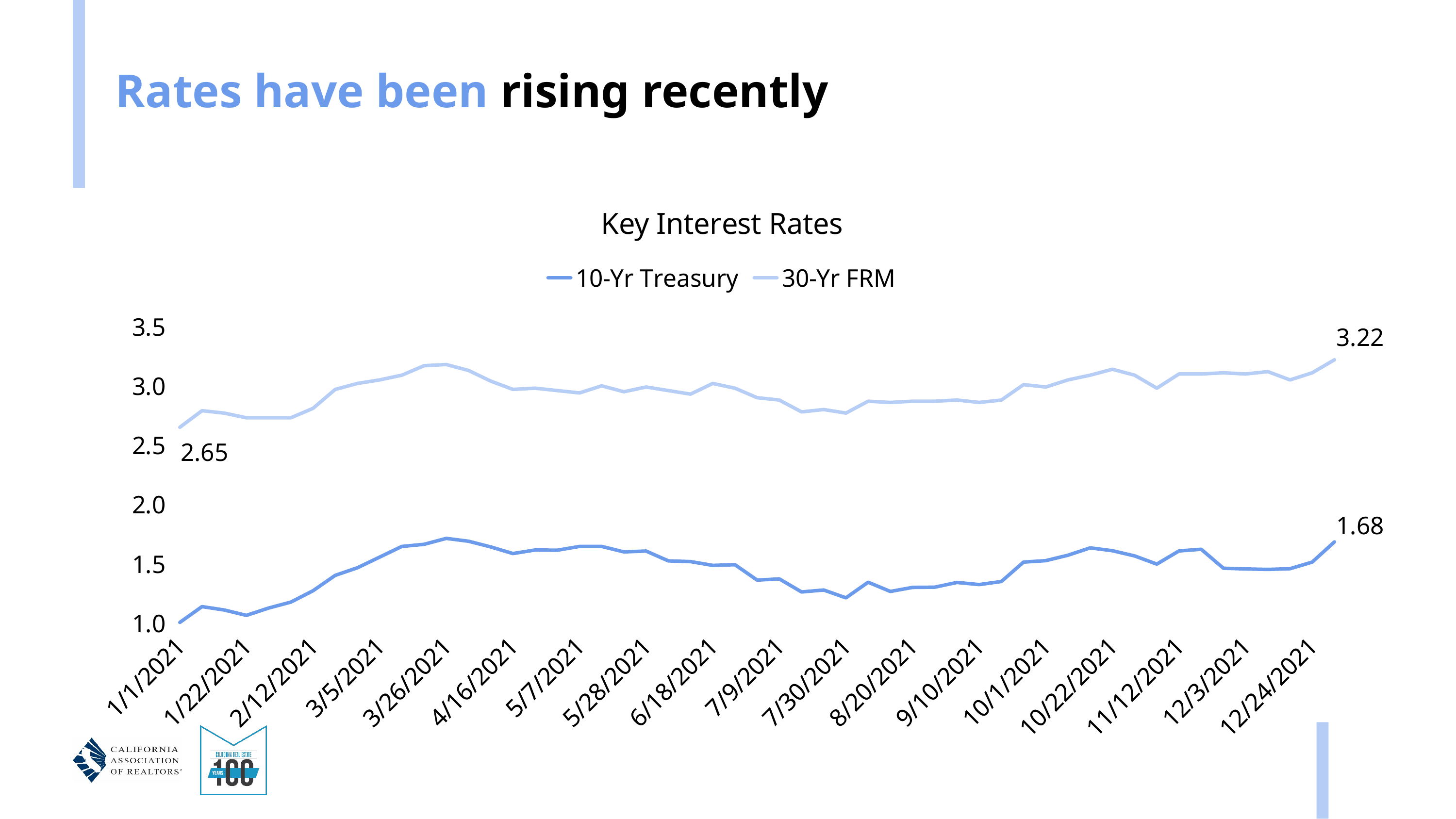
By how much did the 30-Yr FRM rise from its labeled starting value to its labeled ending value? 0.57 Is the value of the 10-Yr Treasury at 1/1/2021 greater or less than 1.5? less How many series does the legend of the Key Interest Rates chart list? 2 Which series has the higher value at the end of the chart, 10-Yr Treasury or 30-Yr FRM? 30-Yr FRM What is the difference between the labeled ending values of the 30-Yr FRM and the 10-Yr Treasury? 1.54 What is the labeled value of the 30-Yr FRM series at the start of the chart (1/1/2021)? 2.65 Overall, does the 30-Yr FRM series rise or fall from the start of the chart to the end? rise What kind of chart is shown on the slide? line chart What is the title of the chart on the slide? Key Interest Rates Is the value of the 30-Yr FRM around 3/26/2021 greater or less than 3.0? greater What is the labeled value of the 10-Yr Treasury series at the end of the chart? 1.68 What is the labeled value of the 30-Yr FRM series at the end of the chart? 3.22